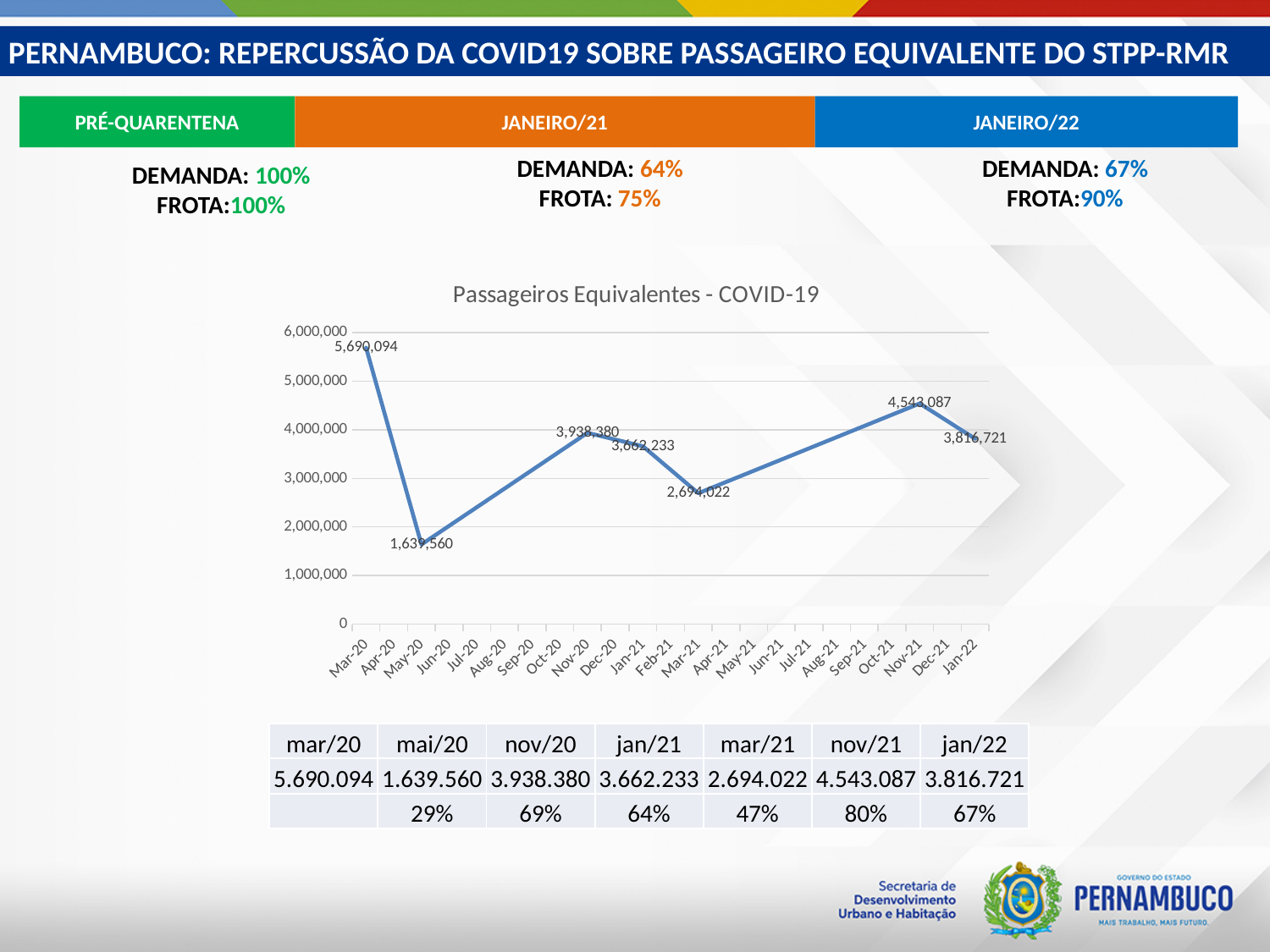
Which month has the highest plotted value? Mar-20 What is the difference between the values for Nov-21 and Jan-22? 726,366 Which month has the lowest plotted value? May-20 What is the difference between the values for Mar-20 and May-20? 4,050,534 How many data points are labelled on the line? 7 What is the title of the chart? Passageiros Equivalentes - COVID-19 What is the value plotted for Jan-22? 3,816,721 What type of chart is shown on the slide? Line chart What is the value plotted for Nov-21? 4,543,087 What is the value plotted for May-20? 1,639,560 What is the value plotted for Mar-20? 5,690,094 Which is larger, the value for Nov-20 or the value for Mar-21? Nov-20